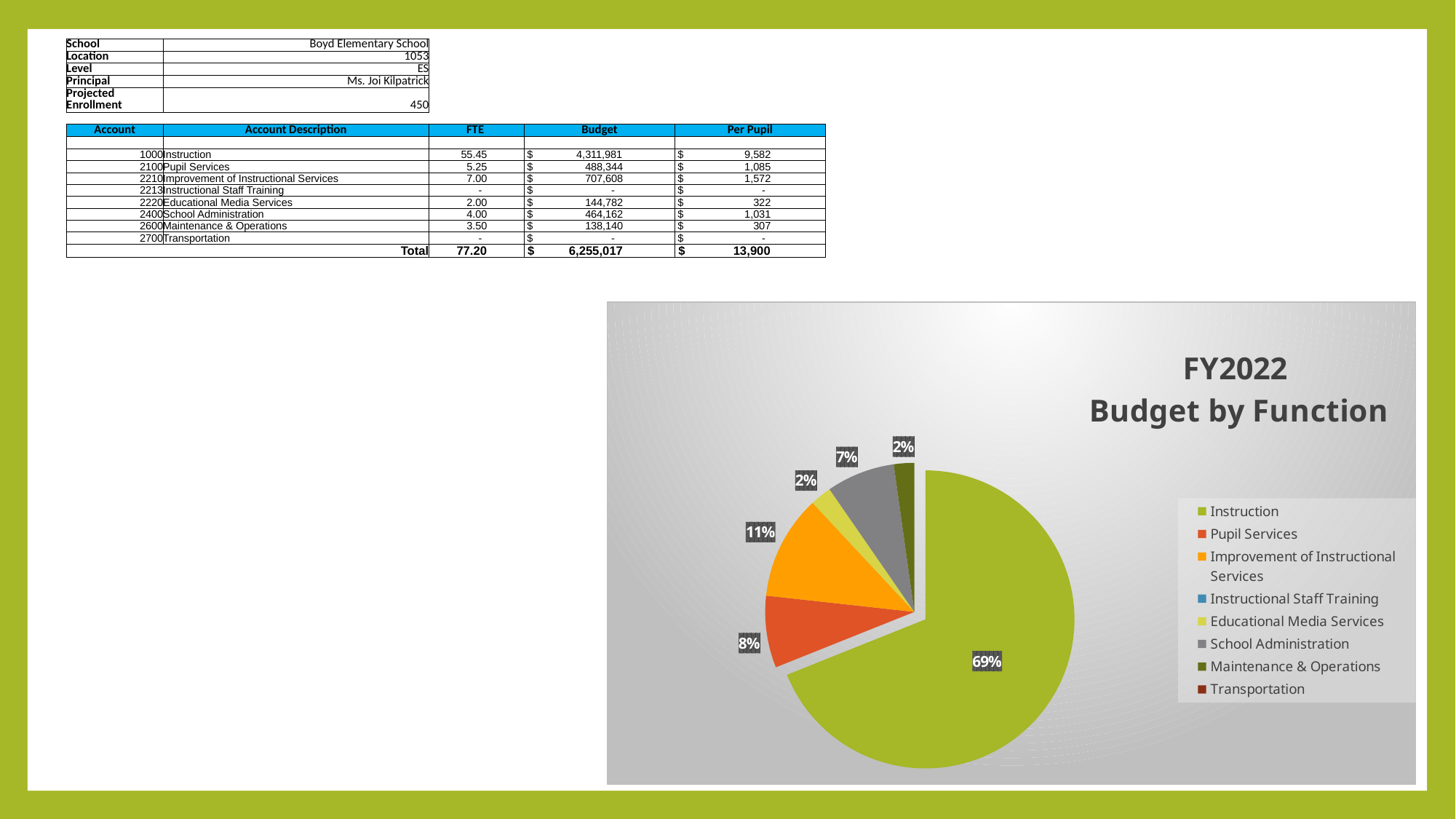
What percentage is shown for Educational Media Services? 2% Which is larger: the share for School Administration or for Pupil Services? Pupil Services Which function has the largest share of the budget? Instruction What percentage of the budget goes to Pupil Services? 8% How many percentage points larger is the Instruction share than the Improvement of Instructional Services share? 58 percentage points What share of the budget does Instruction account for in the pie chart? 69% What percentage of the budget is School Administration? 7% What percentage is shown for Improvement of Instructional Services? 11% How many entries does the chart legend list? 8 Which is larger: the share for Pupil Services or for Improvement of Instructional Services? Improvement of Instructional Services What is the title of the chart? FY2022 Budget by Function What kind of chart is shown on the slide? pie chart